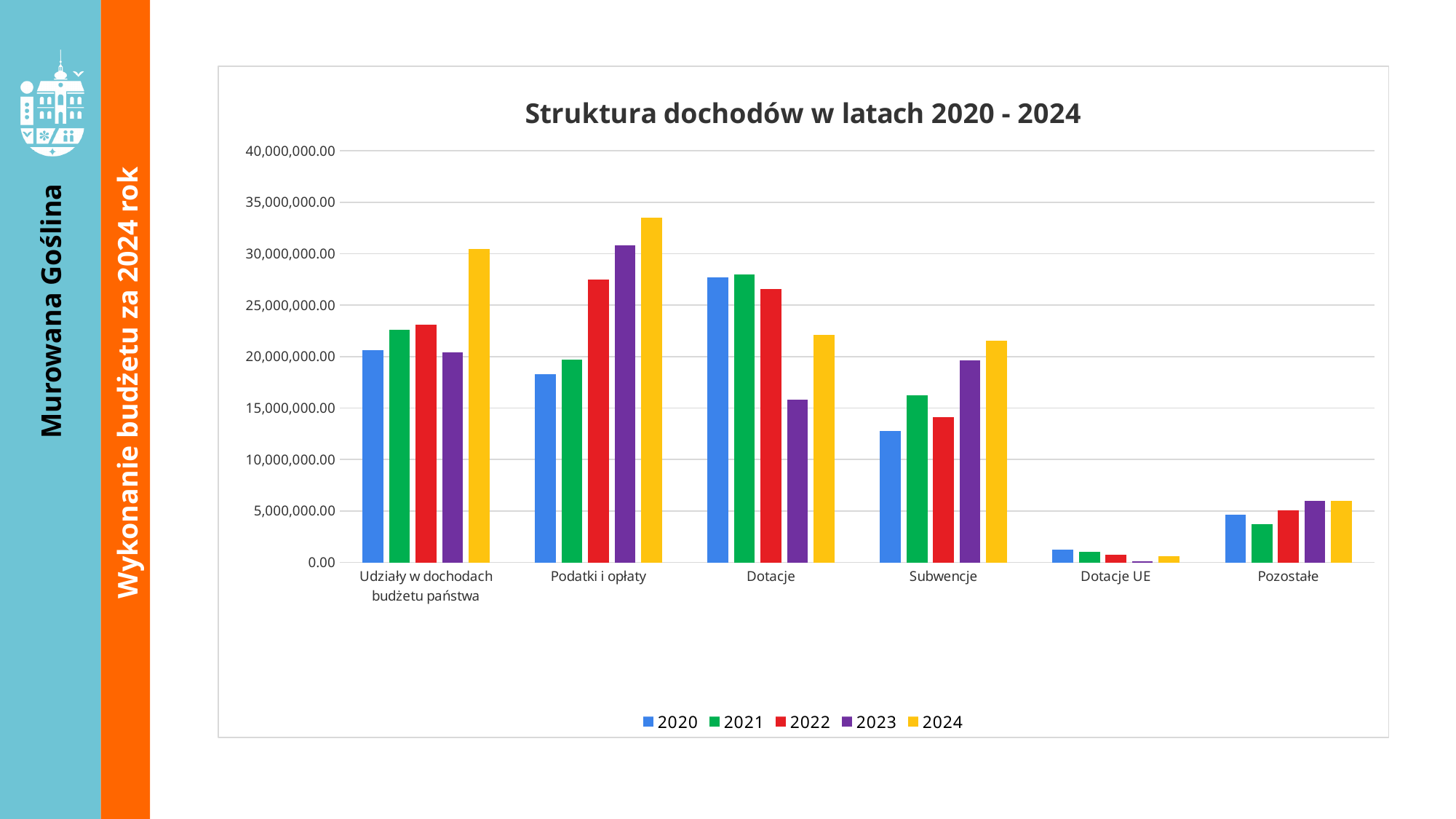
Is the 2020 value for Subwencje greater or less than 15,000,000.00? less Which category has the highest bar for 2024? Podatki i opłaty Is the 2023 value for Dotacje greater or less than 20,000,000.00? less What kind of chart is shown on the slide? bar chart How many categories are shown on the x axis? 6 What is the title of the chart? Struktura dochodów w latach 2020 - 2024 For 2020, which is larger: Dotacje or Subwencje? Dotacje Is the 2024 value for Podatki i opłaty greater or less than 30,000,000.00? greater For Udziały w dochodach budżetu państwa, which year has the larger value: 2020 or 2024? 2024 Which category has the lowest bar for 2023? Dotacje UE How many series does the legend list? 5 Do the values for Podatki i opłaty rise or fall from 2020 to 2024? rise